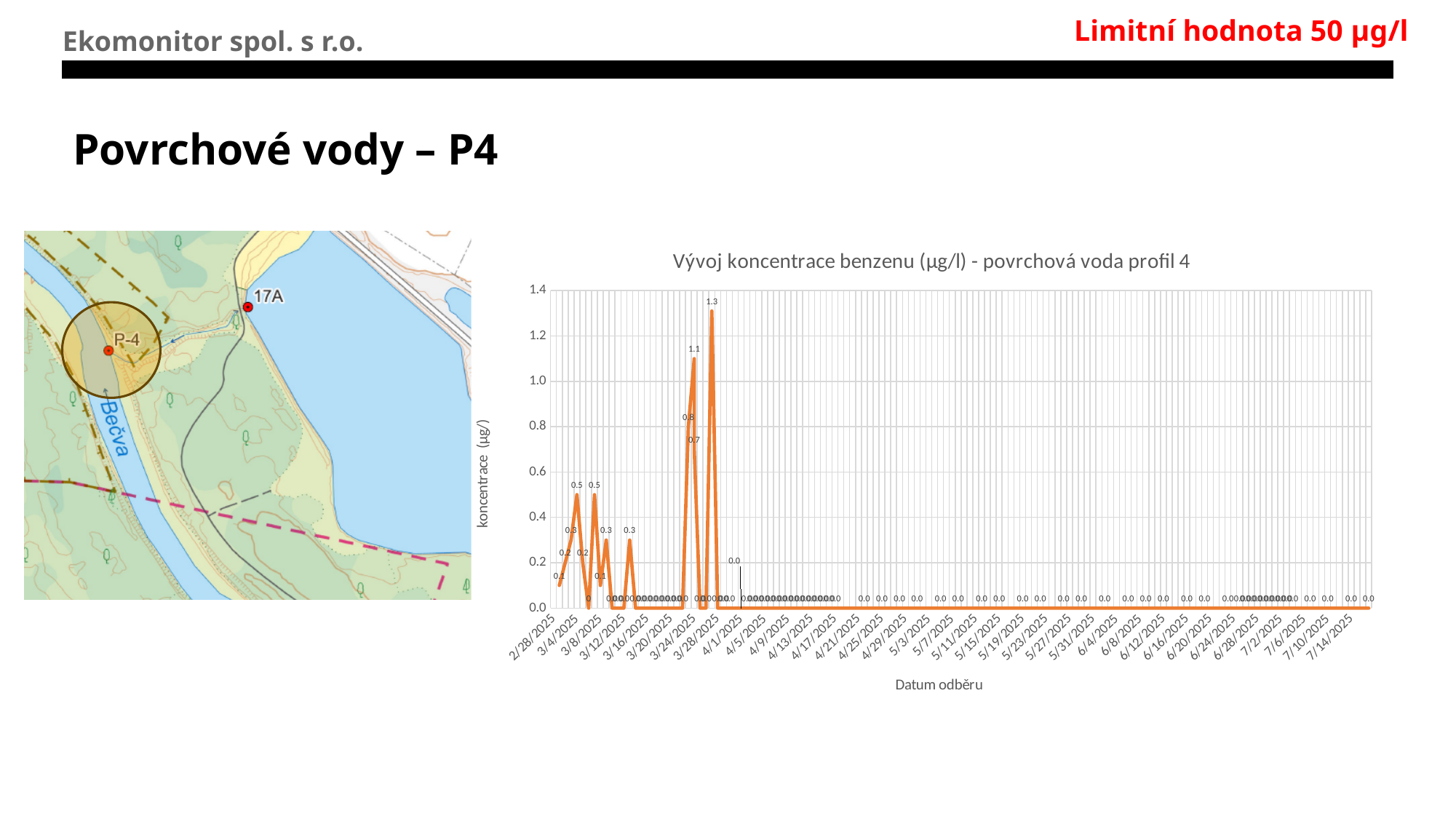
What is the highest value shown on the y axis of the chart? 1.4 Which is larger, the peak labelled 1.1 or the peak labelled 0.8? 1.1 Is the highest value on the chart greater or less than 1.2? greater What value do the data labels show for the points from April 2025 onward? 0.0 What is the title of the chart? Vývoj koncentrace benzenu (µg/l) - povrchová voda profil 4 What kind of chart is shown on the slide? line chart What is the highest data label value plotted on the chart? 1.3 What is the label of the x axis of the chart? Datum odběru Is the peak labelled 0.8 greater or less than 1.0? less Do the values in the chart rise or fall overall from the end of March 2025 to July 2025? fall What is the difference between the two highest labelled peaks, 1.3 and 1.1? 0.2